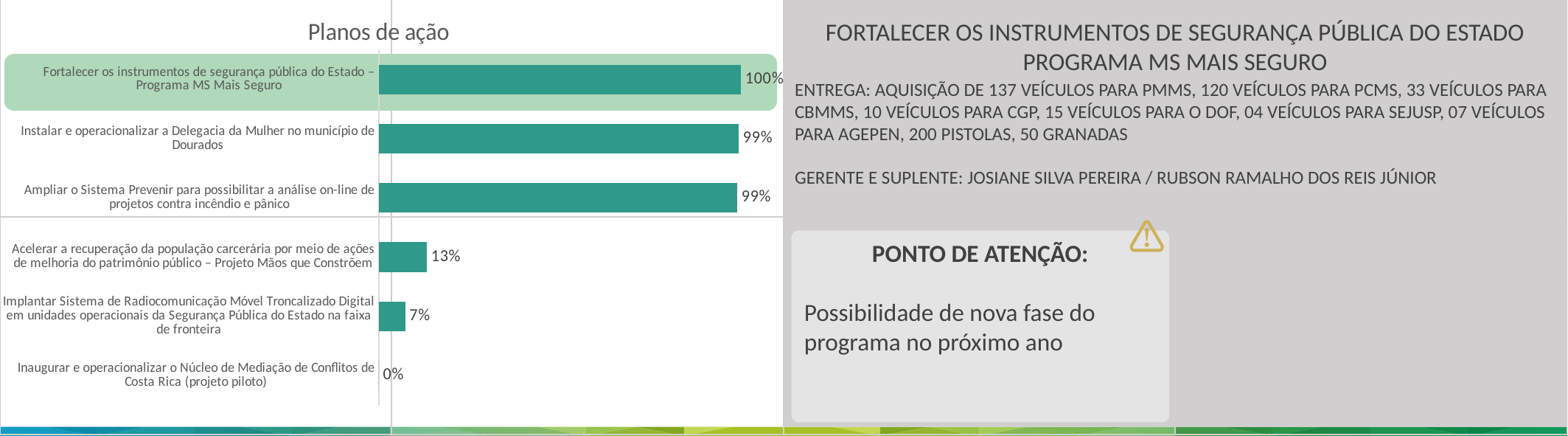
What is the difference between the value for 'Acelerar a recuperação da população carcerária...' (Projeto Mãos que Constrõem) and the value for 'Implantar Sistema de Radiocomunicação Móvel Troncalizado Digital...'? 6% What is the title of the chart? Planos de ação What kind of chart is shown on the slide? bar chart What is the value for 'Inaugurar e operacionalizar o Núcleo de Mediação de Conflitos de Costa Rica (projeto piloto)'? 0% Which has a larger value: 'Ampliar o Sistema Prevenir para possibilitar a análise on-line de projetos contra incêndio e pânico' or 'Acelerar a recuperação da população carcerária... Projeto Mãos que Constrõem'? Ampliar o Sistema Prevenir para possibilitar a análise on-line de projetos contra incêndio e pânico What is the value for 'Acelerar a recuperação da população carcerária por meio de ações de melhoria do patrimônio público – Projeto Mãos que Constrõem'? 13% What is the value for 'Instalar e operacionalizar a Delegacia da Mulher no município de Dourados'? 99% Which action plan has the lowest value? Inaugurar e operacionalizar o Núcleo de Mediação de Conflitos de Costa Rica (projeto piloto) What is the value for 'Implantar Sistema de Radiocomunicação Móvel Troncalizado Digital em unidades operacionais da Segurança Pública do Estado na faixa de fronteira'? 7% How many action plans (categories) are shown in the chart? 6 Which action plan has the highest value? Fortalecer os instrumentos de segurança pública do Estado – Programa MS Mais Seguro What is the value for 'Fortalecer os instrumentos de segurança pública do Estado – Programa MS Mais Seguro'? 100%